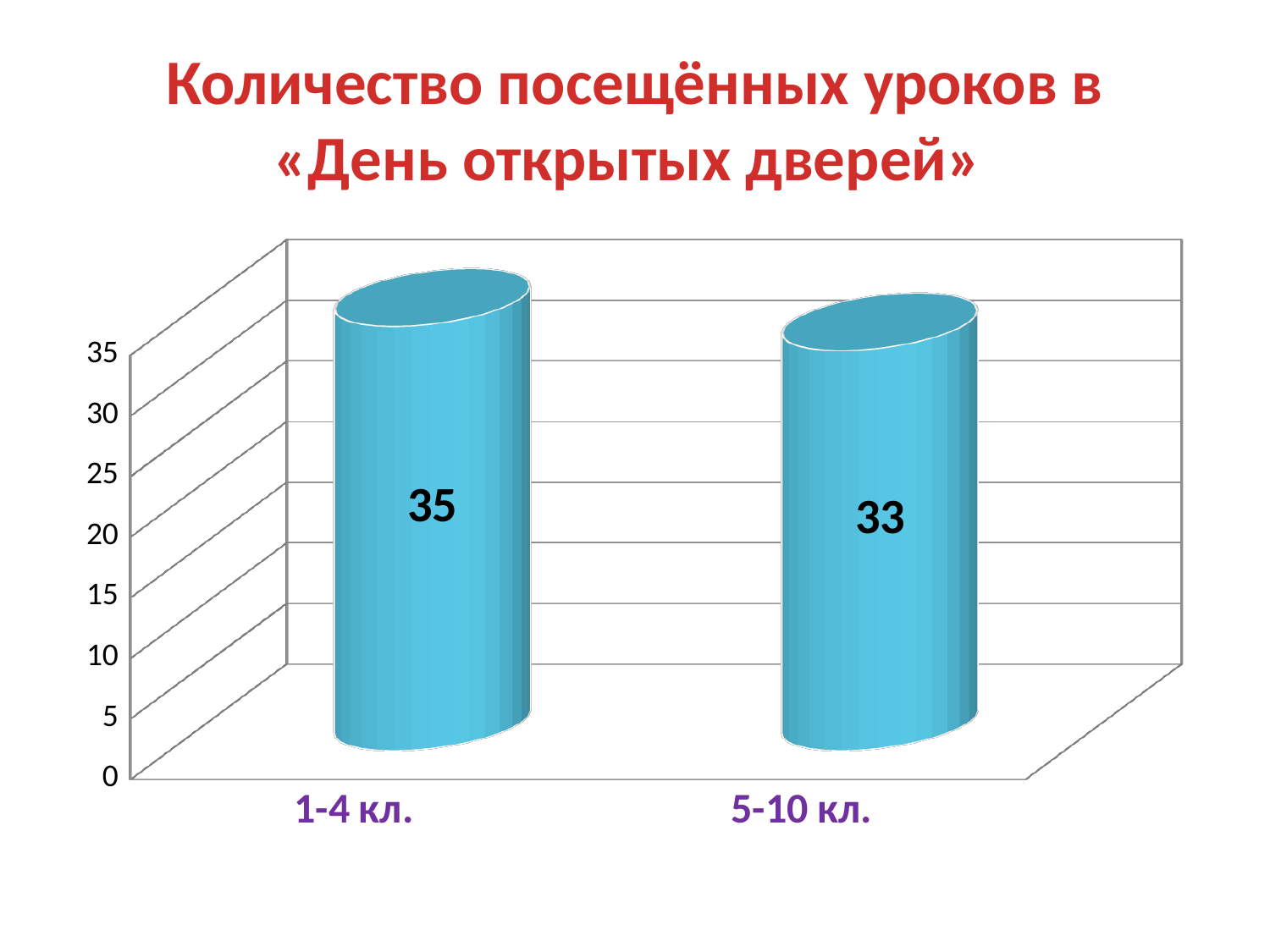
Is the value for 5-10 кл. greater or less than 30? greater Which category has the lowest value? 5-10 кл. What is the value for 5-10 кл.? 33 How many categories are shown on the chart? 2 What is the difference between the values for 1-4 кл. and 5-10 кл.? 2 What is the highest value shown on the vertical axis? 35 Which is larger, the value for 1-4 кл. or for 5-10 кл.? 1-4 кл. What kind of chart is shown on the slide? bar chart What is the value for 1-4 кл.? 35 Do the values rise or fall from 1-4 кл. to 5-10 кл.? fall Which category has the highest value? 1-4 кл. What is the title of the chart? Количество посещённых уроков в «День открытых дверей»